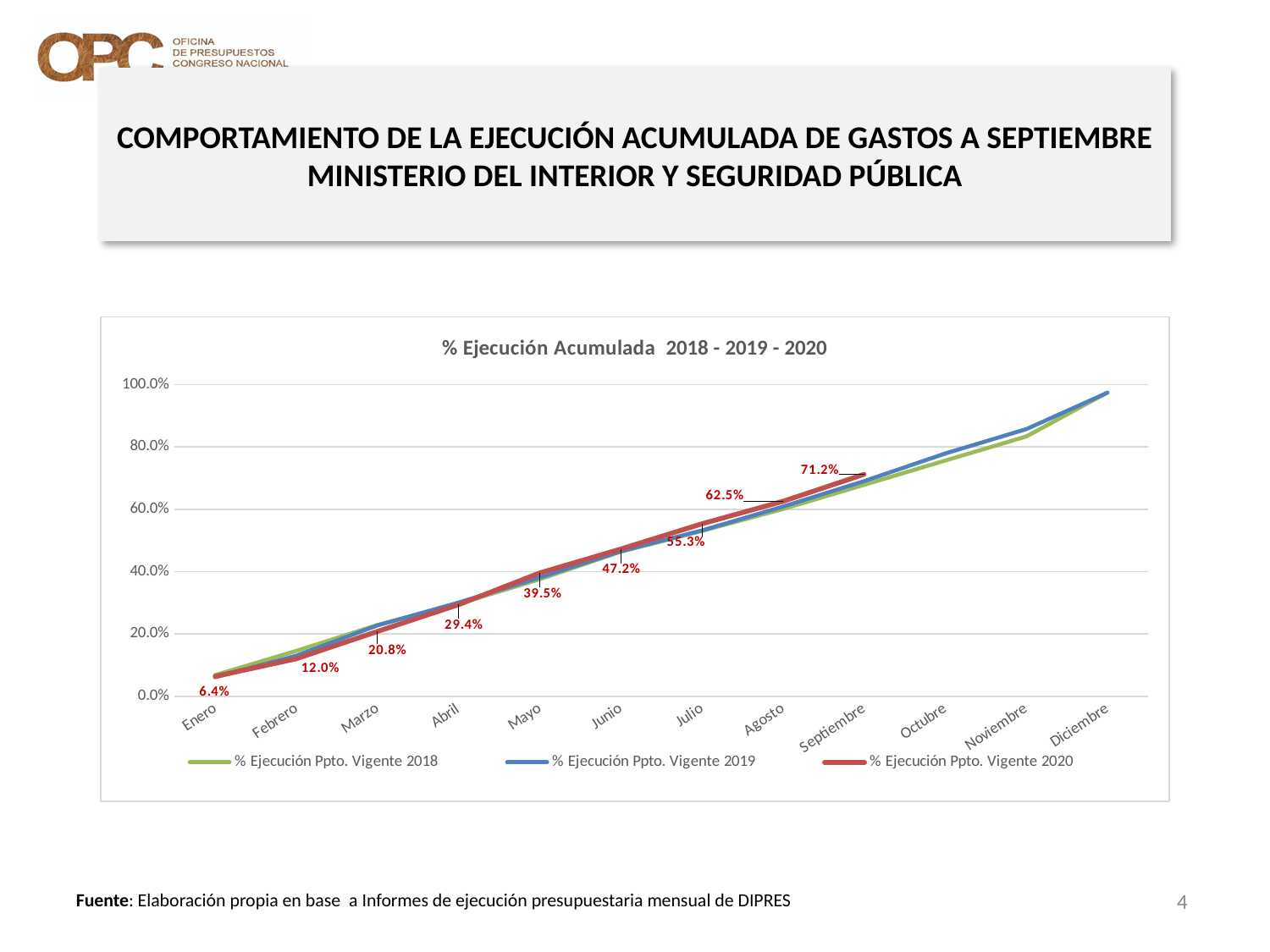
What is the value for Agosto in the % Ejecución Ppto. Vigente 2020 series? 62.5% Is the value for Diciembre in the % Ejecución Ppto. Vigente 2019 series greater or less than 80.0%? greater What is the value for Septiembre in the % Ejecución Ppto. Vigente 2020 series? 71.2% What is the difference between the Marzo and Febrero values in the % Ejecución Ppto. Vigente 2020 series? 8.8% What is the value for Enero in the % Ejecución Ppto. Vigente 2020 series? 6.4% Do the values of the % Ejecución Ppto. Vigente 2020 series rise or fall from Enero to Septiembre? Rise What kind of chart is shown on the slide? Line chart What is the value for Mayo in the % Ejecución Ppto. Vigente 2020 series? 39.5% What is the title of the chart? % Ejecución Acumulada 2018 - 2019 - 2020 What is the difference between the Septiembre and Agosto values in the % Ejecución Ppto. Vigente 2020 series? 8.7% How many series does the legend list? 3 How many months are shown on the x axis? 12